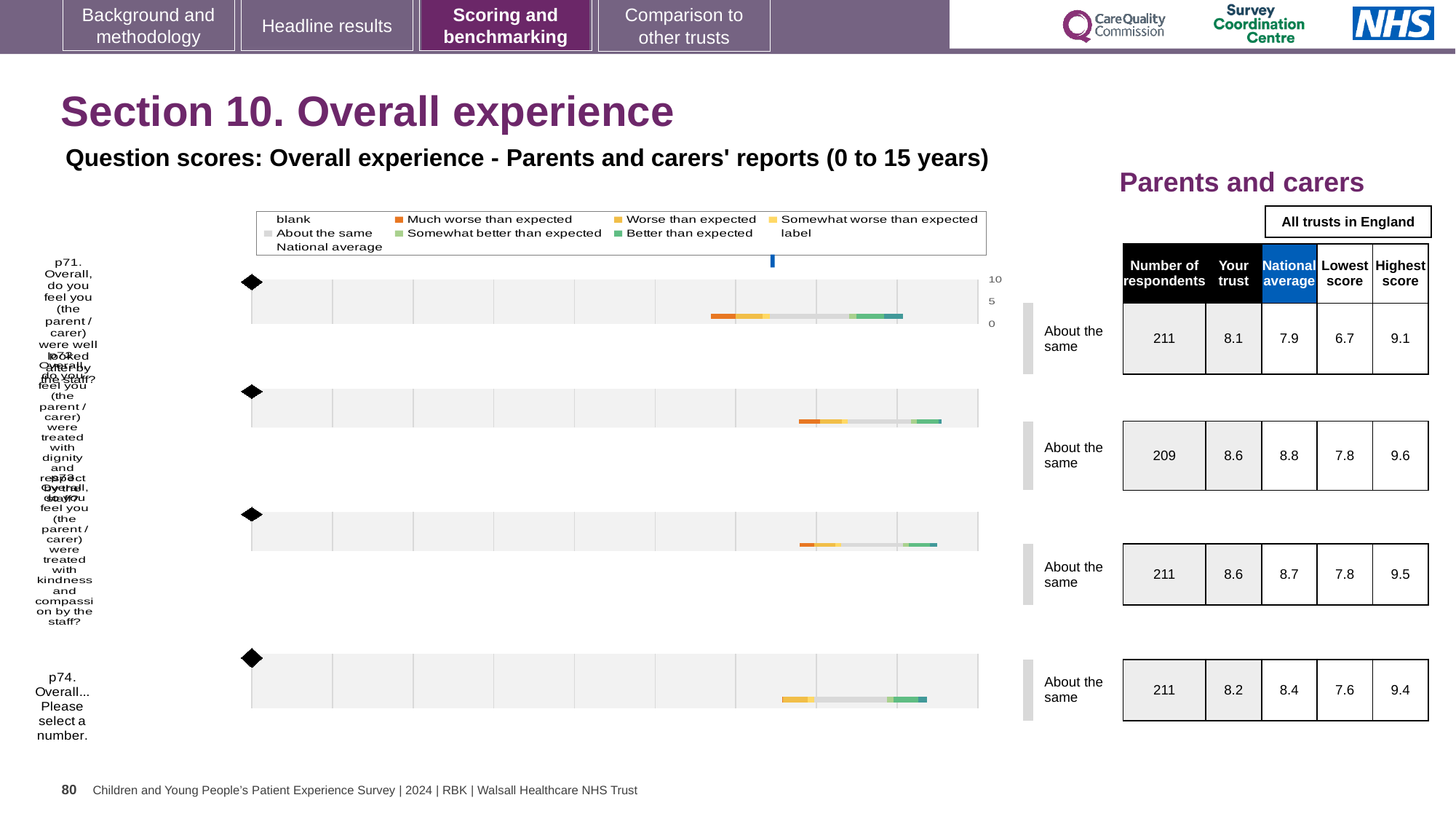
What is the number of respondents for question p71 (Overall, do you feel you were well looked after by the staff?)? 211 For question p71, which is larger: the 'Your trust' score or the national average? Your trust What is the lowest score among all trusts in England for question p74? 7.6 What benchmark category label is shown next to question p74? About the same What kind of chart is used to show the question scores on this slide? bar chart What is the highest score among all trusts in England for question p74 (Overall... Please select a number)? 9.4 What is the difference between the highest score and the lowest score for question p71? 2.4 How many question rows are plotted in the chart? 4 What is the national average score for question p71? 7.9 For question p74, which is larger: the 'Your trust' score or the national average? National average What is the title of the chart? Question scores: Overall experience - Parents and carers' reports (0 to 15 years) What is the 'Your trust' score for question p71? 8.1